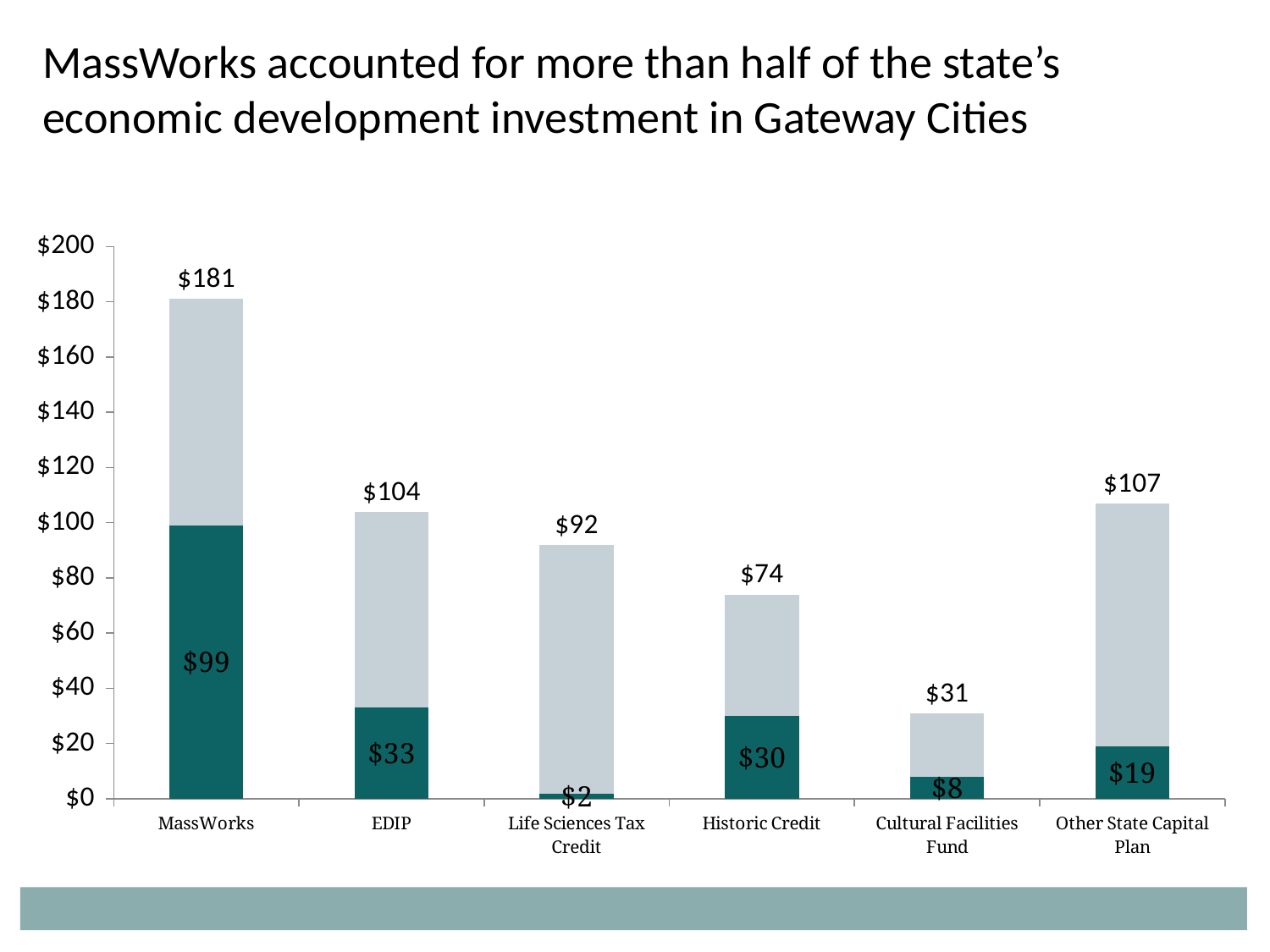
Which category has the lowest total value? Cultural Facilities Fund Is the total value for Life Sciences Tax Credit greater or less than $100? less What is the difference between the total for MassWorks and the total for EDIP? $77 Which category has the highest total value? MassWorks What is the total value labeled above the MassWorks bar? $181 What is the title of the slide? MassWorks accounted for more than half of the state's economic development investment in Gateway Cities What kind of chart is shown on the slide? bar chart Which has the larger total value, Other State Capital Plan or EDIP? Other State Capital Plan What is the value of the dark teal segment of the Life Sciences Tax Credit bar? $2 What is the value of the dark teal segment of the EDIP bar? $33 How many categories are shown along the x axis of the chart? 6 What is the value of the light gray segment of the Historic Credit bar, given its total of $74 and dark segment of $30? $44